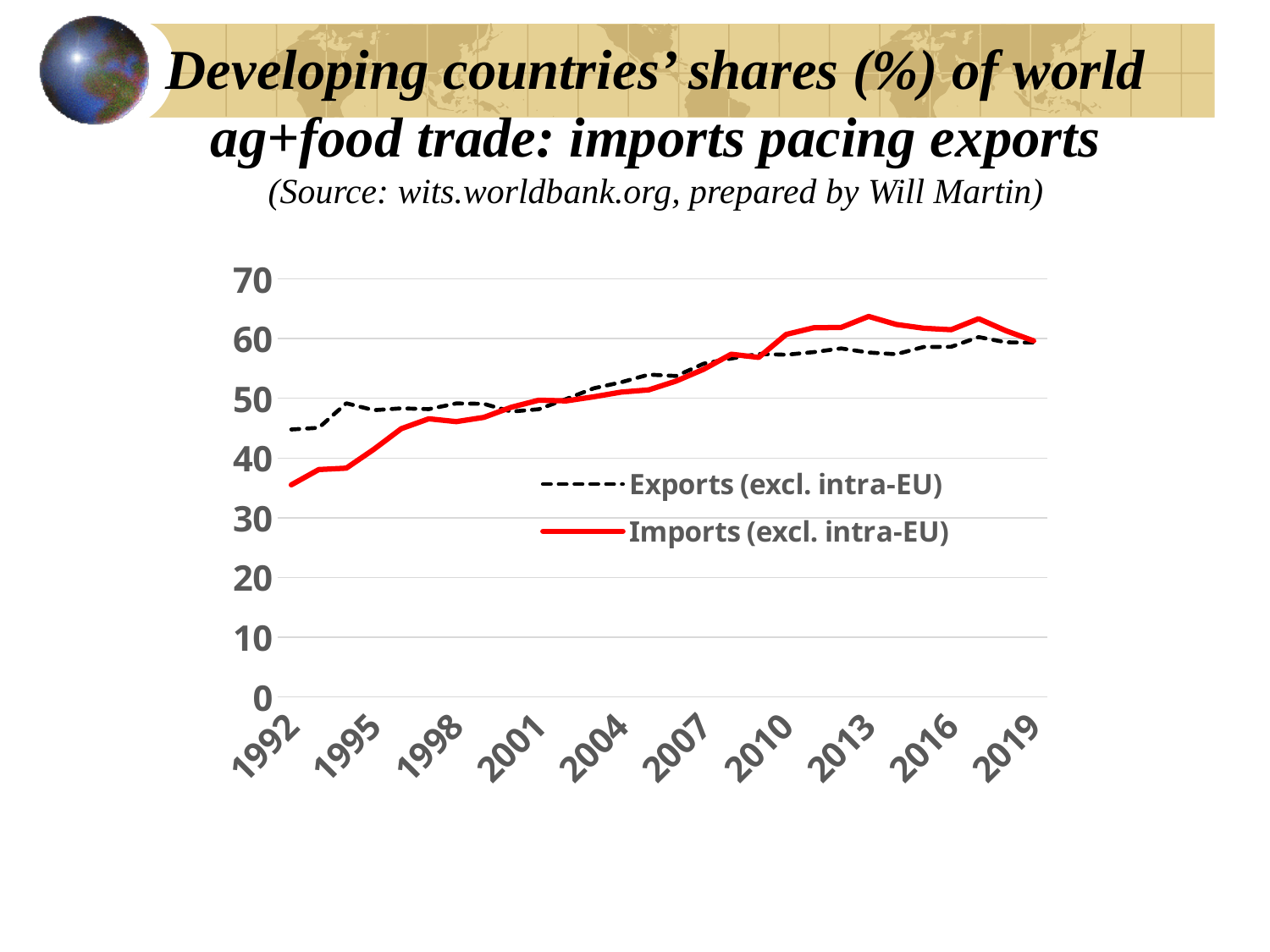
How many series does the legend list? 2 Is the value for Imports (excl. intra-EU) in 1992 greater or less than 40? less Is the value for Exports (excl. intra-EU) in 1992 greater or less than 40? greater Do the values for Imports (excl. intra-EU) generally rise or fall from 1992 to 2019? rise Is the value for Imports (excl. intra-EU) in 2013 greater or less than 60? greater Which series is drawn as a dashed black line? Exports (excl. intra-EU) In 1992, which series has the larger value, Exports (excl. intra-EU) or Imports (excl. intra-EU)? Exports (excl. intra-EU) Which series is drawn as a solid red line? Imports (excl. intra-EU) What kind of chart is shown on the slide? line chart In which year is the value for Imports (excl. intra-EU) lowest? 1992 In 2013, which series has the larger value, Exports (excl. intra-EU) or Imports (excl. intra-EU)? Imports (excl. intra-EU)